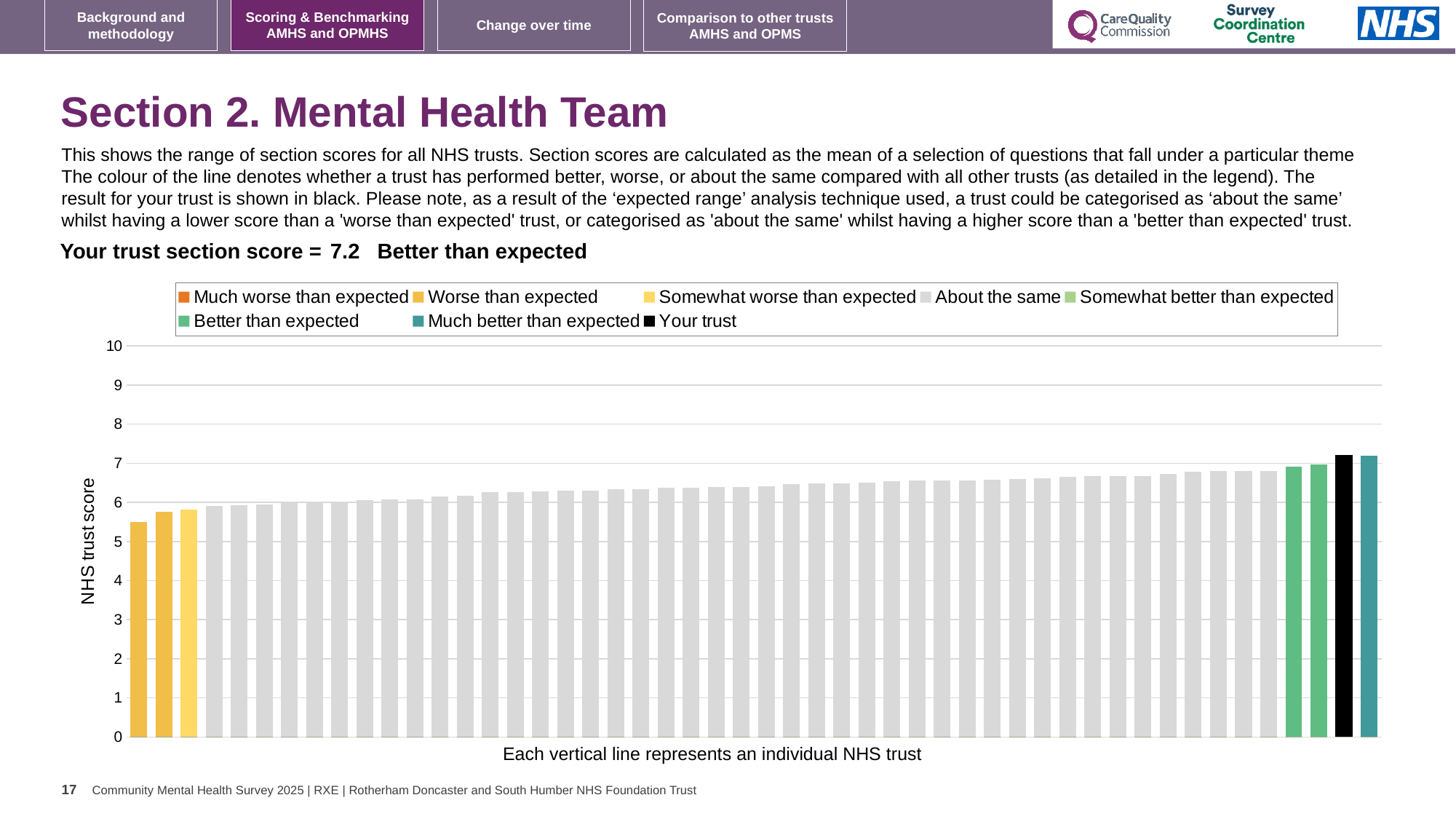
What colour is the bar representing your trust? black Do the bar values rise or fall from left to right along the x axis? rise What kind of chart is shown on the slide? bar chart Which category is your trust's section score placed in, according to the text above the chart? Better than expected Is the value of the lowest bar greater or less than 5? greater Is the value of the highest bar greater or less than 8? less How many entries does the chart legend list? 8 What is the section score for your trust shown on the slide? 7.2 Is the value of the lowest bar greater or less than 6? less What is the label on the vertical axis of the chart? NHS trust score